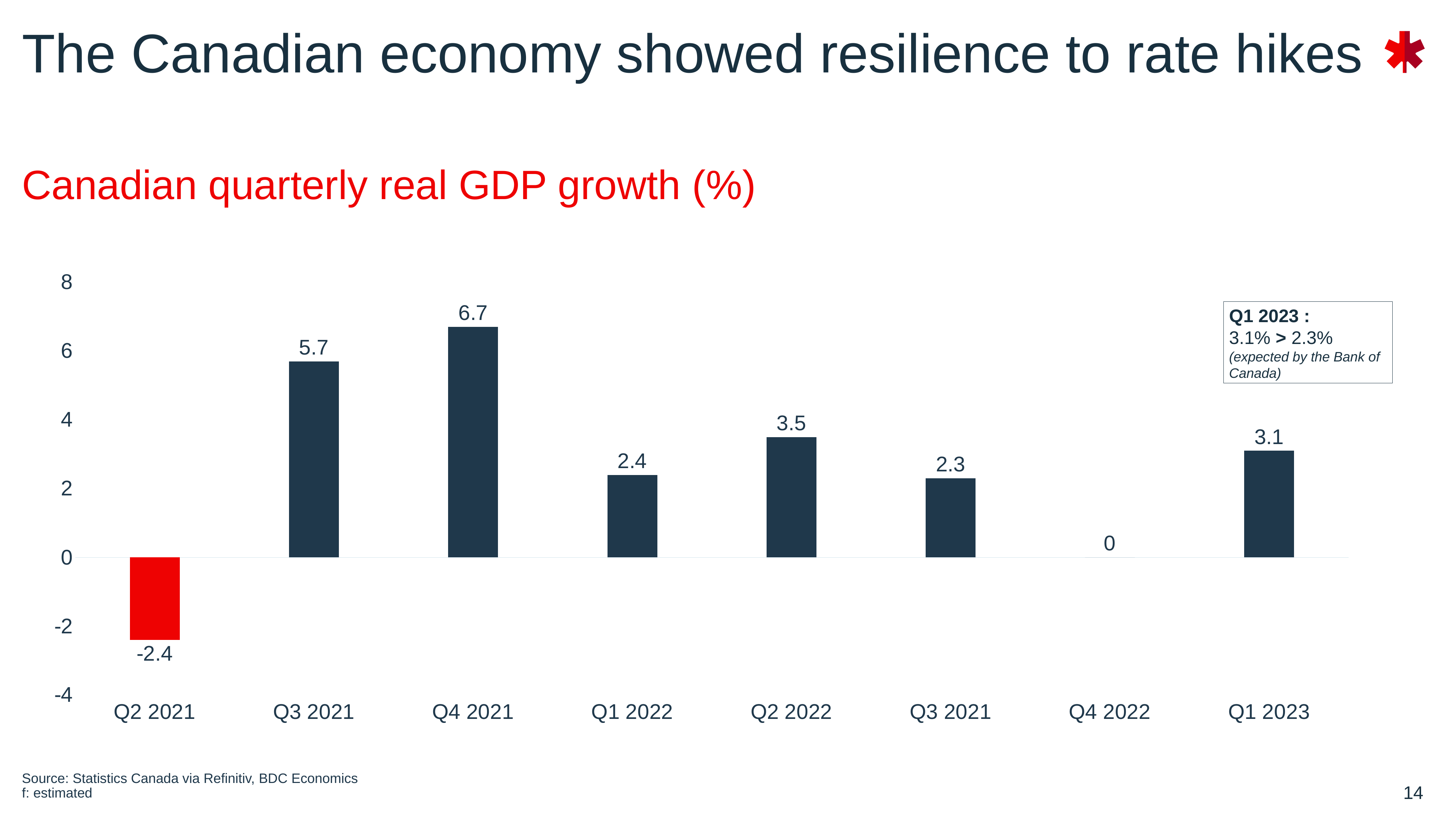
What is the value shown for Q1 2023? 3.1 What is the value shown for Q2 2021? -2.4 Which quarter has the highest real GDP growth in the chart? Q4 2021 What is the difference between the values for Q4 2021 and Q1 2022? 4.3 What type of chart is shown on the slide? bar chart Which bar is coloured red rather than dark blue? Q2 2021 Which is larger, the value for Q2 2022 or the value for Q1 2023? Q2 2022 What is the value shown for Q4 2022? 0 How many quarters (bars) are shown in the chart? 8 What is the Canadian quarterly real GDP growth value for Q4 2021? 6.7 What is the title of the chart? Canadian quarterly real GDP growth (%) Which quarter has the lowest real GDP growth in the chart? Q2 2021